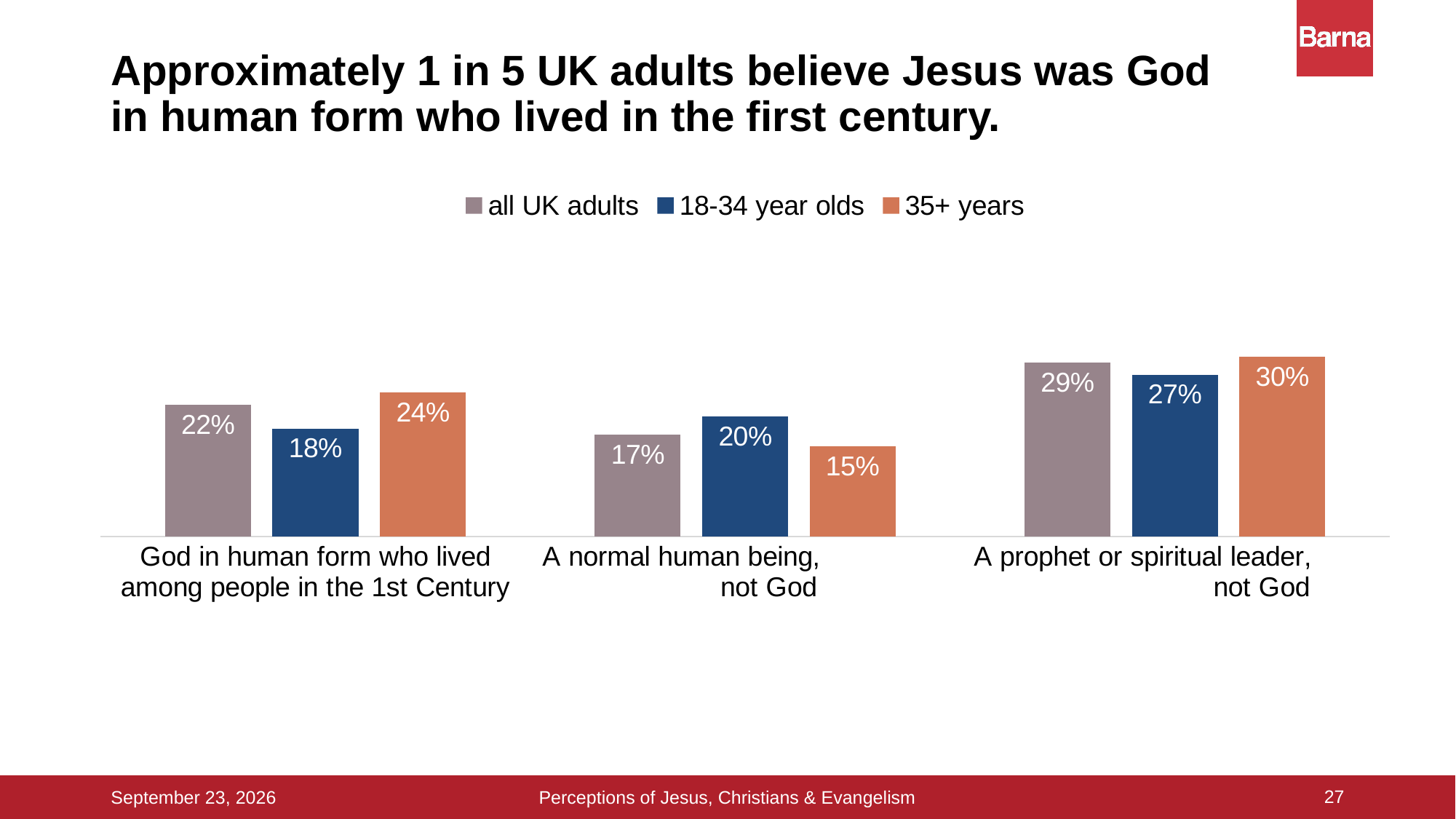
What is the value for 18-34 year olds for 'A normal human being, not God'? 20% What is the difference between the all UK adults and 18-34 year olds values for 'A prophet or spiritual leader, not God'? 2% What kind of chart is shown on the slide? Bar chart How many categories are shown on the x axis? 3 How many series does the legend list? 3 Which series is shown in orange in the legend? 35+ years Which category has the highest value for all UK adults? A prophet or spiritual leader, not God For 'A normal human being, not God', which is larger: the value for 18-34 year olds or for 35+ years? 18-34 year olds What is the difference between the 35+ years and 18-34 year olds values for 'God in human form who lived among people in the 1st Century'? 6% Which category has the lowest value for 35+ years? A normal human being, not God What percentage of all UK adults believe Jesus was God in human form who lived among people in the 1st Century? 22% What is the value for 35+ years for 'A prophet or spiritual leader, not God'? 30%